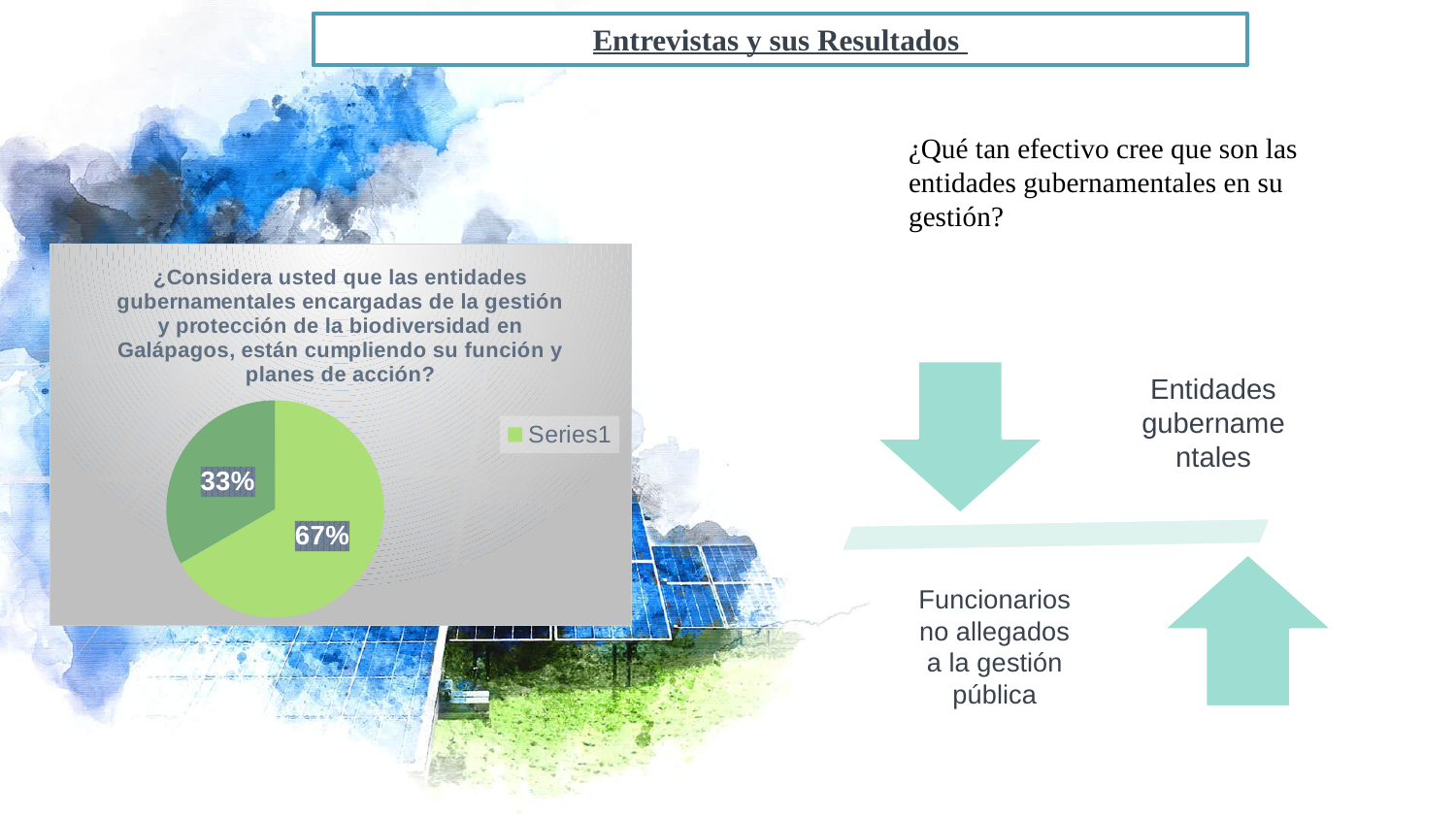
Is the value of the darker green slice of the pie chart greater or less than 50%? less What is the value of the smallest slice in the pie chart? 33% How many series does the legend of the pie chart list? 1 How many slices does the pie chart have? 2 What percentage is shown on the light green slice of the pie chart? 67% What question does the title of the pie chart ask? ¿Considera usted que las entidades gubernamentales encargadas de la gestión y protección de la biodiversidad en Galápagos, están cumpliendo su función y planes de acción? What kind of chart is shown on the slide? pie chart What is the difference between the two slices of the pie chart? 34% What percentage is shown on the darker green slice of the pie chart? 33% Which slice of the pie chart is larger, the light green one or the darker green one? the light green one What is the value of the largest slice in the pie chart? 67% What is the name of the series shown in the pie chart's legend? Series1